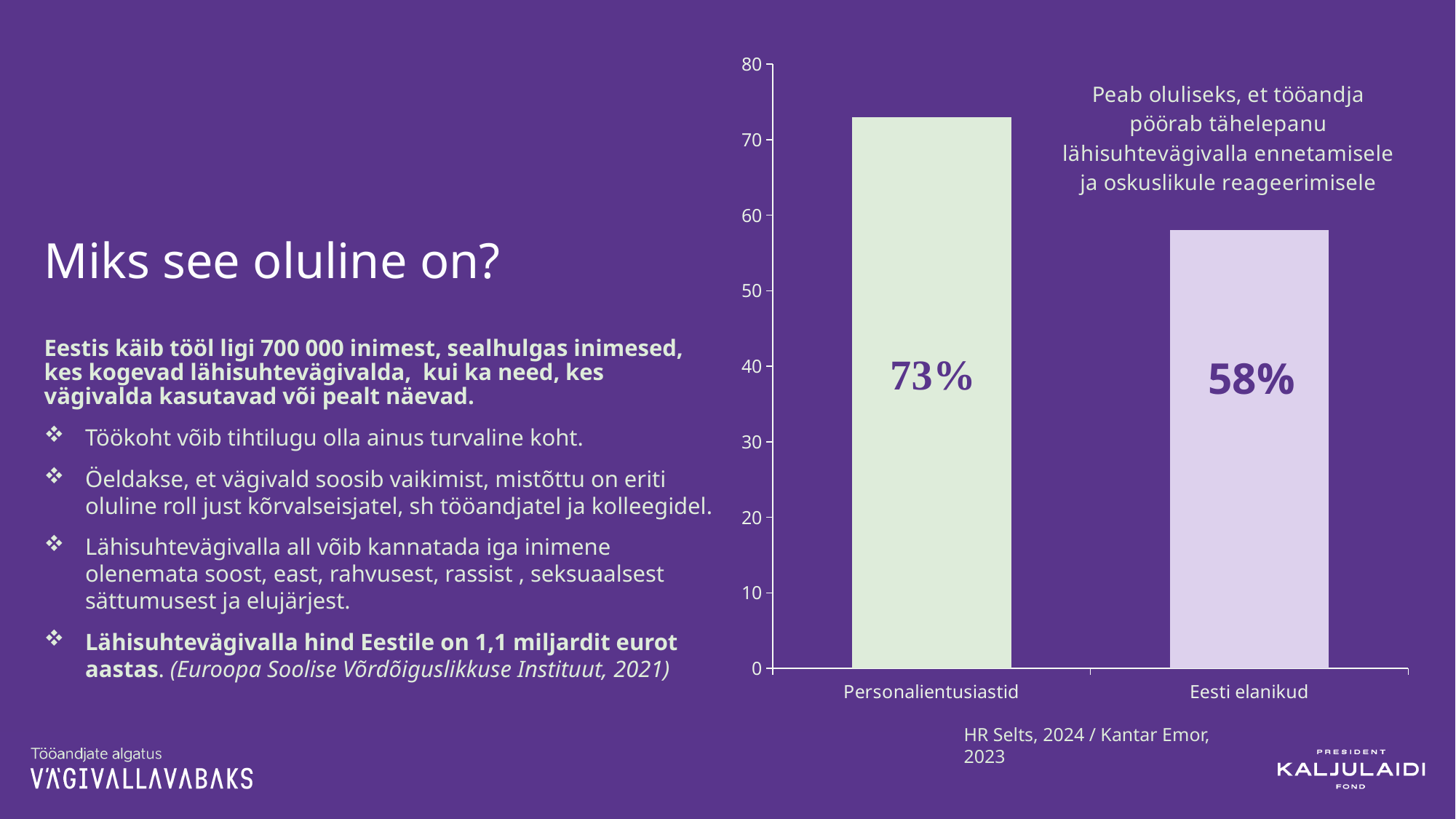
How many categories are shown on the chart? 2 Which is larger, the value for Personalientusiastid or for Eesti elanikud? Personalientusiastid Is the value for Eesti elanikud greater or less than 60? less Is the value for Personalientusiastid greater or less than 70? greater What is the highest value shown on the chart's vertical axis? 80 What kind of chart is shown on the slide? Bar chart What is the value for Personalientusiastid? 73% What source is cited below the chart? HR Selts, 2024 / Kantar Emor, 2023 What is the difference between the values for Personalientusiastid and Eesti elanikud? 15 percentage points What is the value for Eesti elanikud? 58% Which category has the highest value? Personalientusiastid Which category has the lowest value? Eesti elanikud